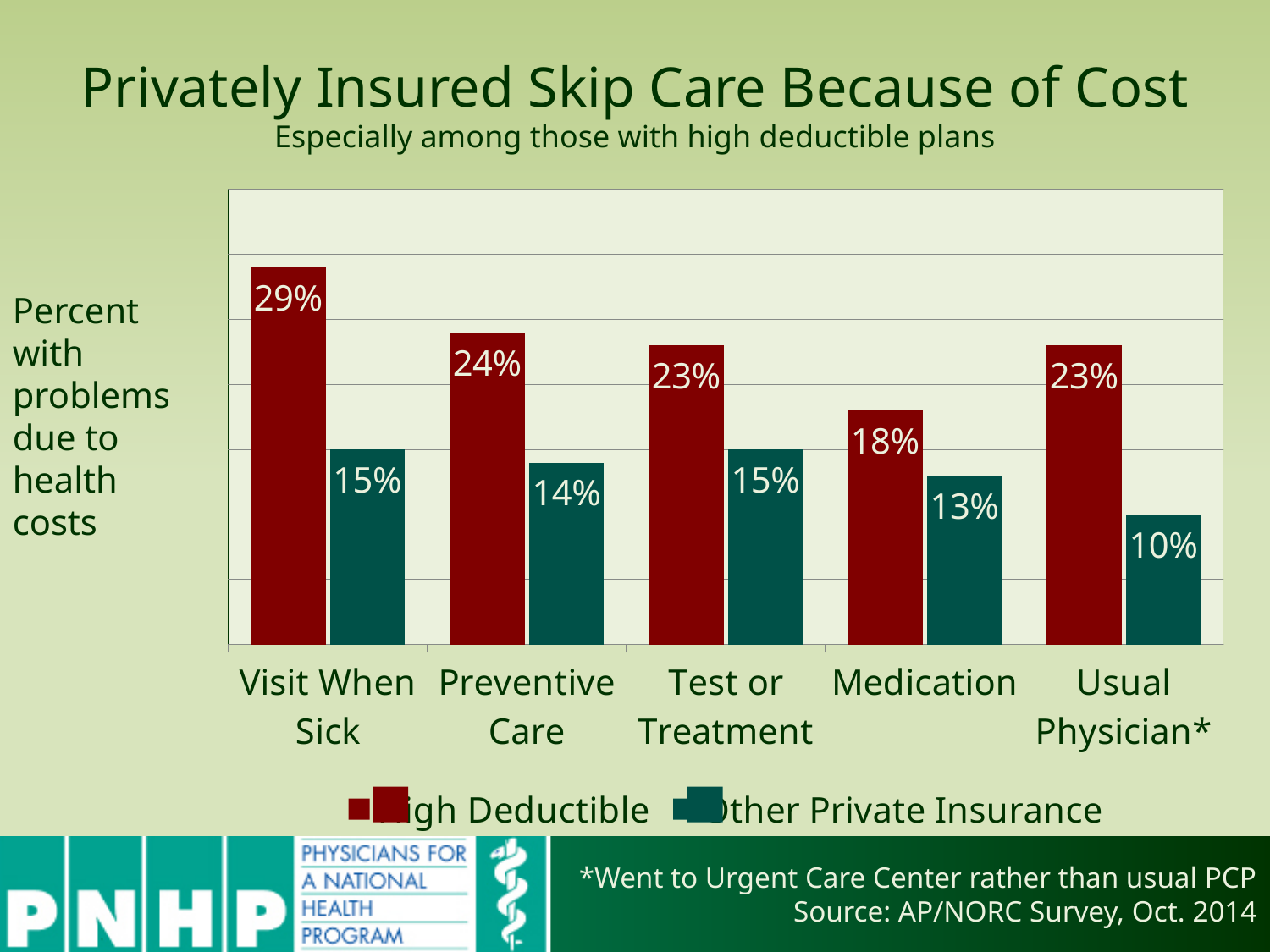
Which category has the highest High Deductible value? Visit When Sick Which is larger: the Other Private Insurance value for Test or Treatment or for Medication? Test or Treatment How many categories are shown on the x axis? 5 What percent of those with High Deductible plans had problems with Visit When Sick? 29% What is the Other Private Insurance value for Usual Physician*? 10% How many series does the legend list? 2 Which category has the lowest Other Private Insurance value? Usual Physician* What colour are the High Deductible bars? Dark red What kind of chart is shown on the slide? Bar chart What is the difference between the High Deductible values for Visit When Sick and Preventive Care? 5% What is the High Deductible value for Medication? 18% What is the difference between the High Deductible and Other Private Insurance values for Usual Physician*? 13%